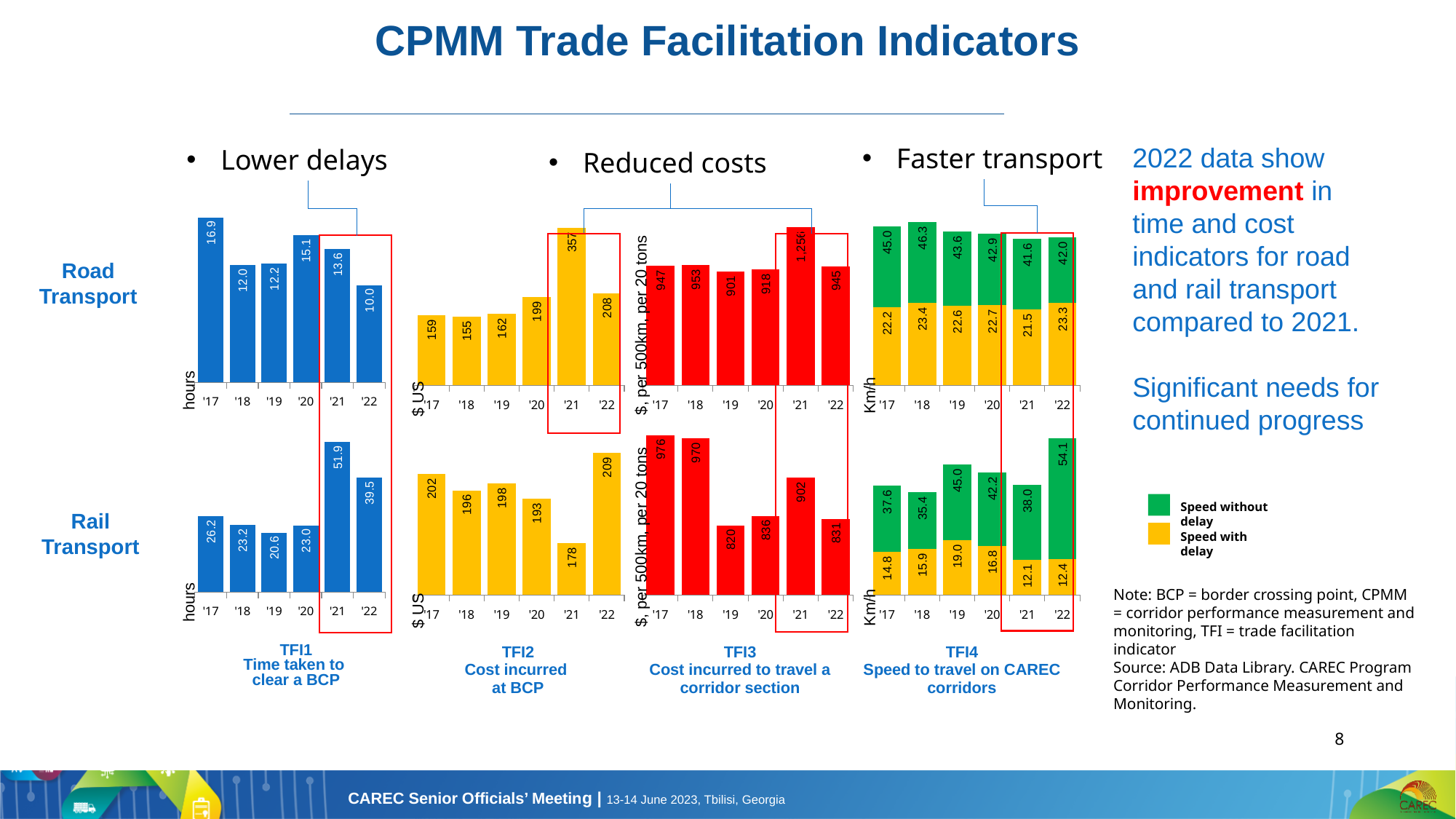
In the Road Transport TFI3 chart (Cost incurred to travel a corridor section), what is the difference between the '21 and '22 values? 311 In the Rail Transport TFI4 chart (Speed to travel on CAREC corridors), what is the Speed without delay value for '22? 54.1 How many years are shown on the x axis of the Road Transport TFI1 chart? 6 In the Road Transport TFI1 chart (Time taken to clear a BCP), what is the difference between the '17 and '22 values? 6.9 In the Rail Transport TFI3 chart (Cost incurred to travel a corridor section), which is larger, the value for '17 or the value for '19? '17 In the Road Transport TFI2 chart (Cost incurred at BCP), what is the value for '21? 357 In the Rail Transport TFI1 chart (Time taken to clear a BCP), which year has the highest value? '21 In the Road Transport TFI1 chart (Time taken to clear a BCP), what is the value for '22? 10.0 In the Rail Transport TFI2 chart (Cost incurred at BCP), which year has the lowest value? '21 In the Road Transport TFI4 chart (Speed to travel on CAREC corridors), what is the Speed with delay value for '21? 21.5 How many series does the legend for the TFI4 charts list? 2 What kind of chart is the Rail Transport TFI2 chart (Cost incurred at BCP)? Bar chart